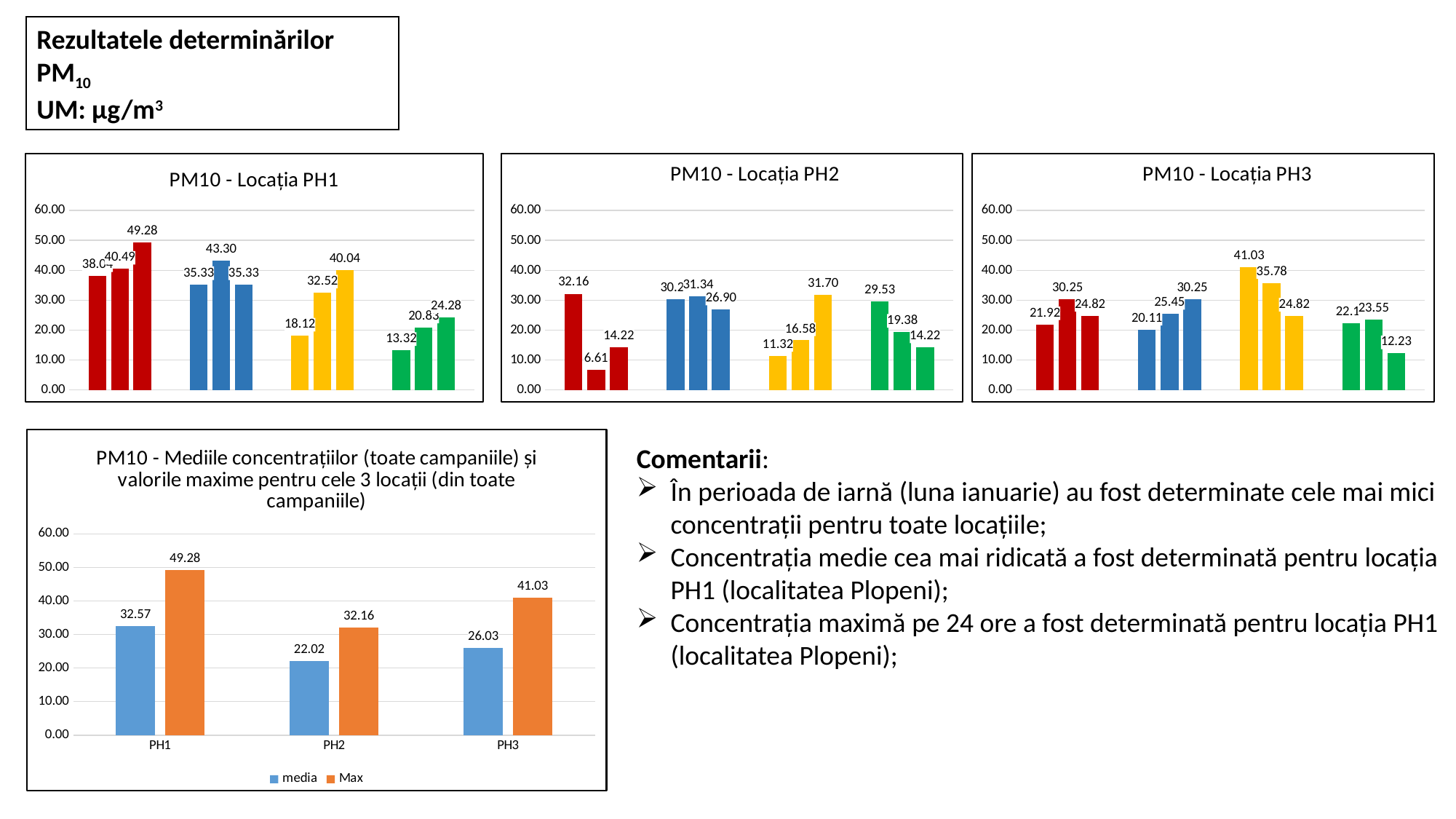
In the bottom-left chart (PM10 - Mediile concentrațiilor...), is the 'Max' value for PH2 larger or the 'Max' value for PH3? PH3 In the bottom-left chart (PM10 - Mediile concentrațiilor...), how many series does the legend list? 2 In the bottom-left chart (PM10 - Mediile concentrațiilor...), how many locations are shown on the x axis? 3 In the chart 'PM10 - Locația PH3', what is the highest value labelled? 41.03 In the bottom-left chart (PM10 - Mediile concentrațiilor...), what is the difference between the 'Max' and 'media' values for PH1? 16.71 In the bottom-left chart (PM10 - Mediile concentrațiilor...), which location has the lowest 'media' value? PH2 In the bottom-left chart (PM10 - Mediile concentrațiilor...), what colour are the 'Max' bars? orange In the bottom-left chart (PM10 - Mediile concentrațiilor...), what is the 'Max' value for PH3? 41.03 In the bottom-left chart (PM10 - Mediile concentrațiilor...), what is the 'media' value for PH1? 32.57 In the chart 'PM10 - Locația PH2', what is the lowest value labelled? 6.61 In the bottom-left chart (PM10 - Mediile concentrațiilor...), which location has the highest 'Max' value? PH1 What kind of chart is 'PM10 - Locația PH1'? bar chart